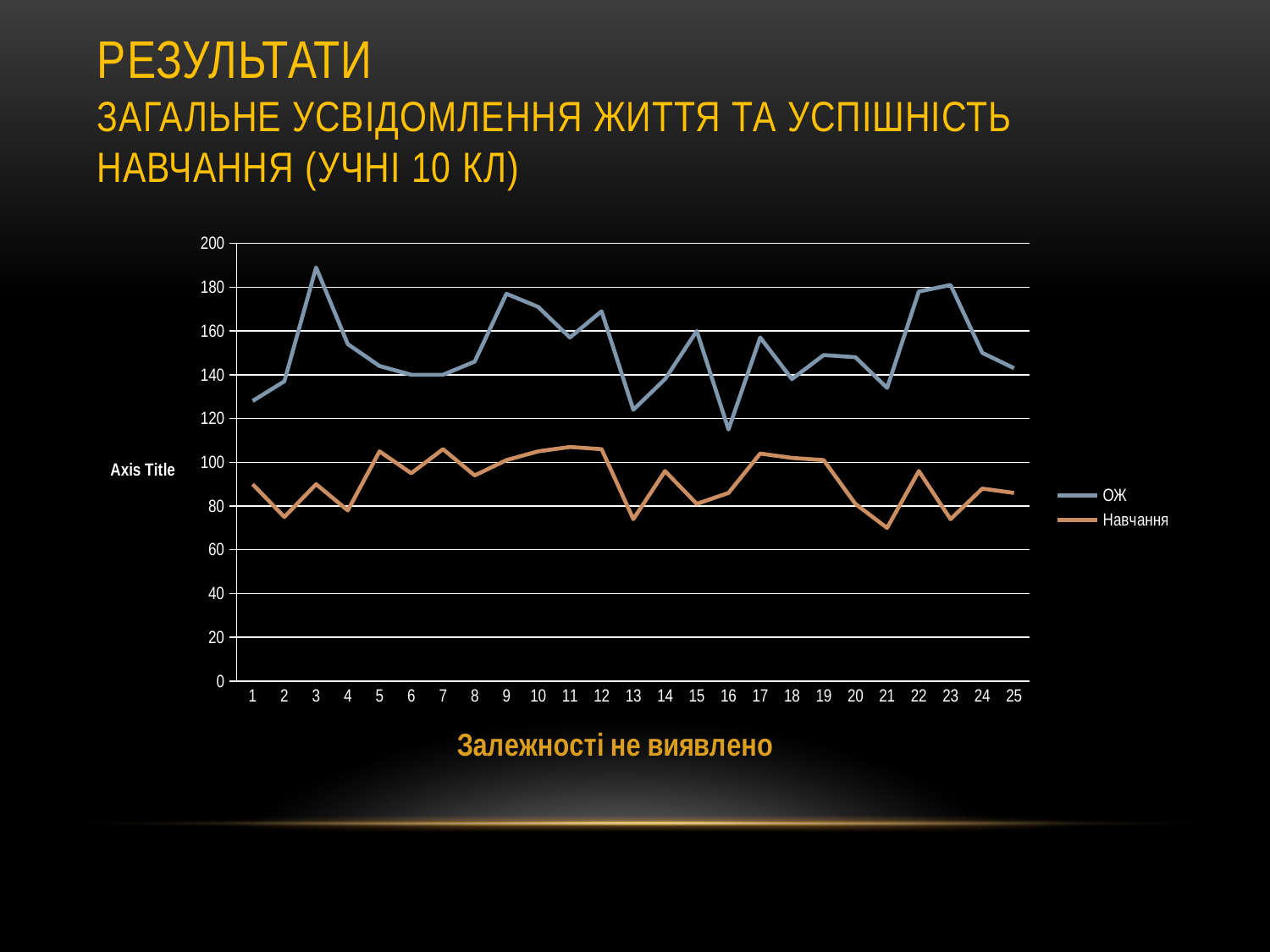
Is the value of ОЖ at point 3 greater or less than 180? greater Which is larger for the Навчання series, the value at point 5 or the value at point 2? point 5 At which x-axis point does the ОЖ series reach its lowest value? 16 Which series has the higher value at point 10, ОЖ or Навчання? ОЖ How many series does the legend list? 2 What kind of chart is shown on the slide? line chart Is the value of Навчання at point 5 greater or less than 100? greater Is the value of ОЖ at point 16 greater or less than 120? less At which x-axis point does the ОЖ series reach its highest value? 3 What are the two entries listed in the chart legend? ОЖ and Навчання How many points are plotted along the x axis for each series? 25